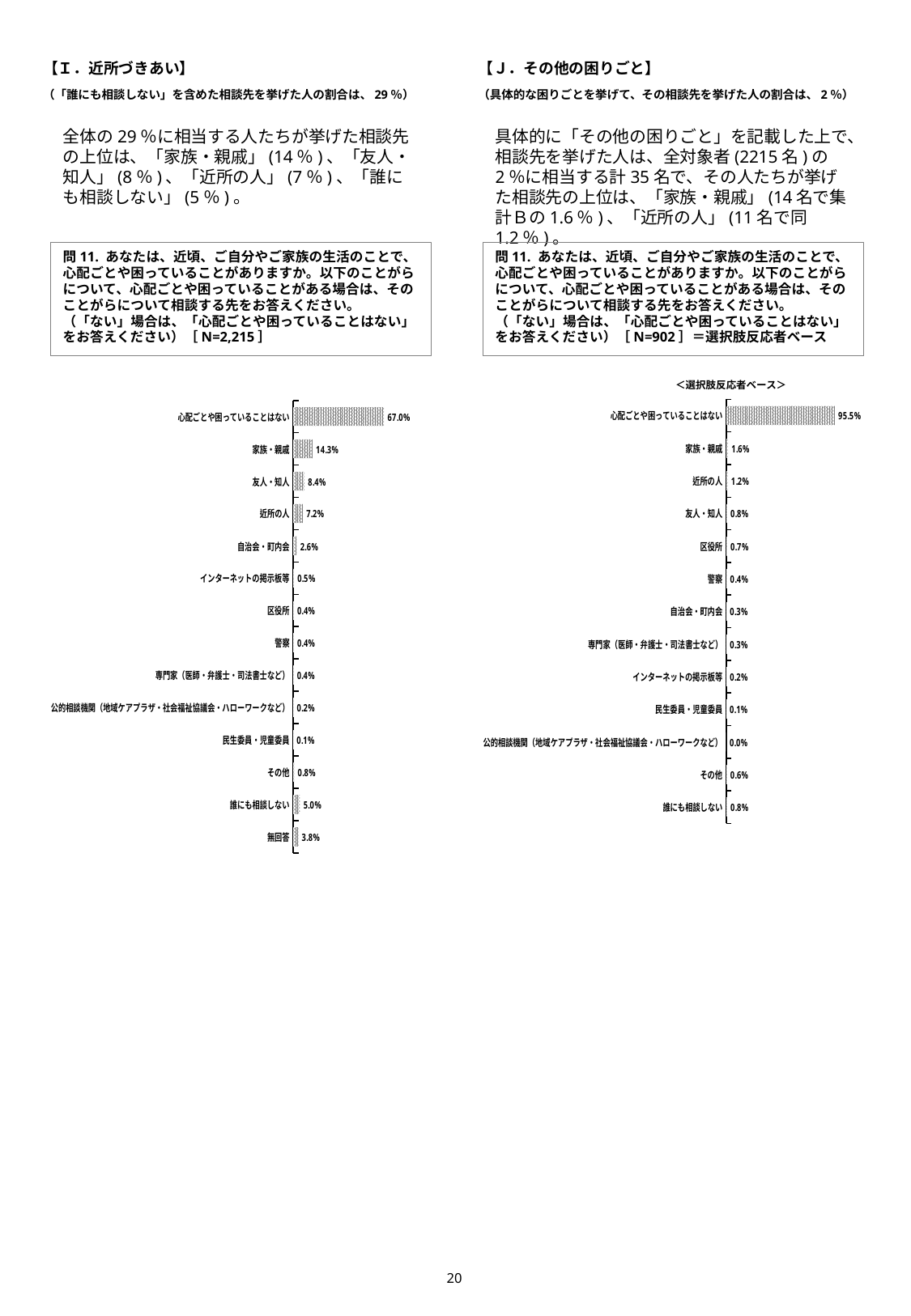
How many categories are shown in the left chart (I. 近所づきあい)? 14 In the right chart (J. その他の困りごと), what is the value for 心配ごとや困っていることはない? 95.5% In the left chart (I. 近所づきあい), which is larger, 近所の人 or 自治会・町内会? 近所の人 What type of chart is used in the right chart (J. その他の困りごと)? Bar chart In the left chart (I. 近所づきあい), which category has the highest value? 心配ごとや困っていることはない In the left chart (I. 近所づきあい), what is the difference between 家族・親戚 and 友人・知人? 5.9% In the right chart (J. その他の困りごと), what is the difference between 家族・親戚 and 近所の人? 0.4% In the right chart (J. その他の困りごと), which category has the lowest value? 公的相談機関（地域ケアプラザ・社会福祉協議会・ハローワークなど） In the left chart (I. 近所づきあい), which category has the lowest value? 民生委員・児童委員 In the right chart (J. その他の困りごと), what is the value for 近所の人? 1.2% In the left chart (I. 近所づきあい), what is the value for 家族・親戚? 14.3% In the left chart (I. 近所づきあい), what is the value for 誰にも相談しない? 5.0%